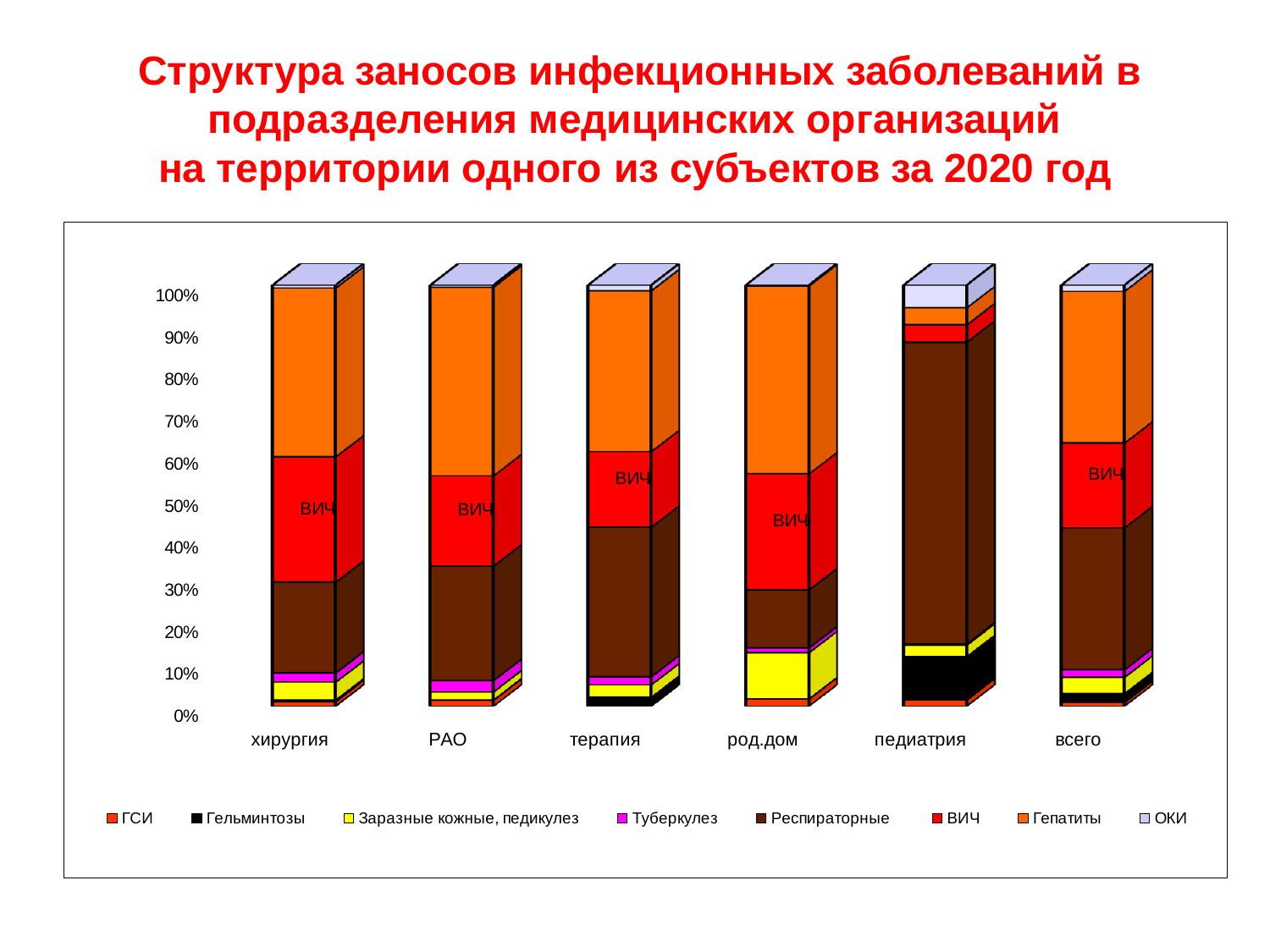
Which series is labelled directly on the bars? ВИЧ How many series does the legend list? 8 Is the share of ВИЧ in педиатрия greater or less than 10%? less Which is larger in РАО: the Гепатиты segment or the ВИЧ segment? Гепатиты Is the share of Гепатиты in хирургия greater or less than 20%? greater Which category has the largest Респираторные segment? педиатрия How many categories (departments) are shown along the x axis? 6 What kind of chart is shown on the slide? stacked bar chart Which category has the smallest Гепатиты segment? педиатрия Is the share of Респираторные in педиатрия greater or less than 50%? greater Which category has the largest Заразные кожные, педикулез segment? род.дом Which category has the largest Гельминтозы segment? педиатрия